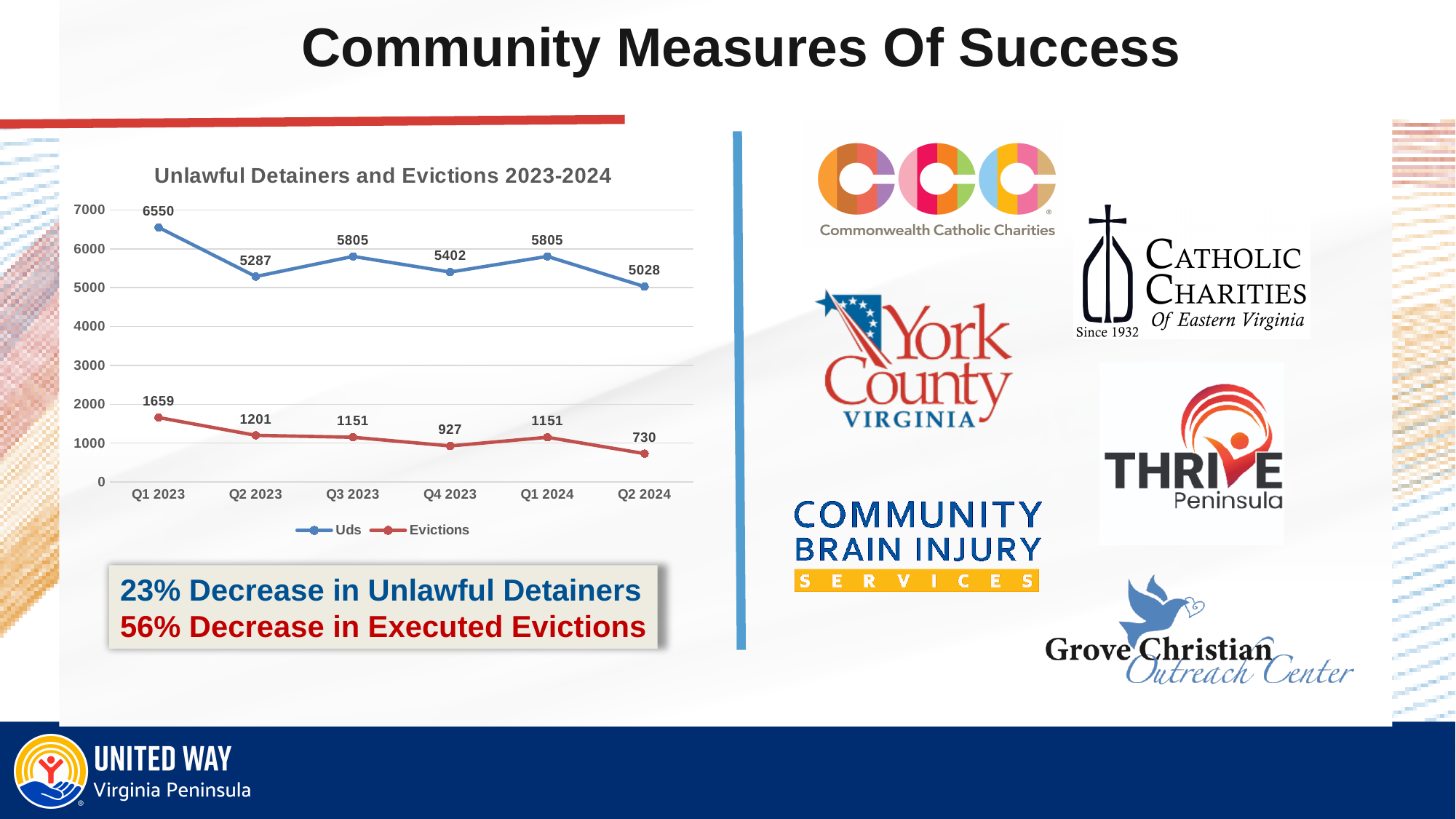
In which quarter is the Evictions value highest? Q1 2023 In which quarter is the Uds value lowest? Q2 2024 How many quarters are plotted on the x axis? 6 What kind of chart is shown on the slide? Line chart How many series does the legend list? 2 What is the difference between the Uds values in Q1 2023 and Q2 2024? 1522 What is the difference between the Evictions values in Q1 2023 and Q2 2024? 929 What is the value for Evictions in Q4 2023? 927 What is the title of the chart? Unlawful Detainers and Evictions 2023-2024 What is the value for Evictions in Q2 2024? 730 What is the value for Uds in Q1 2023? 6550 Which is larger, the Uds value in Q3 2023 or in Q4 2023? Q3 2023